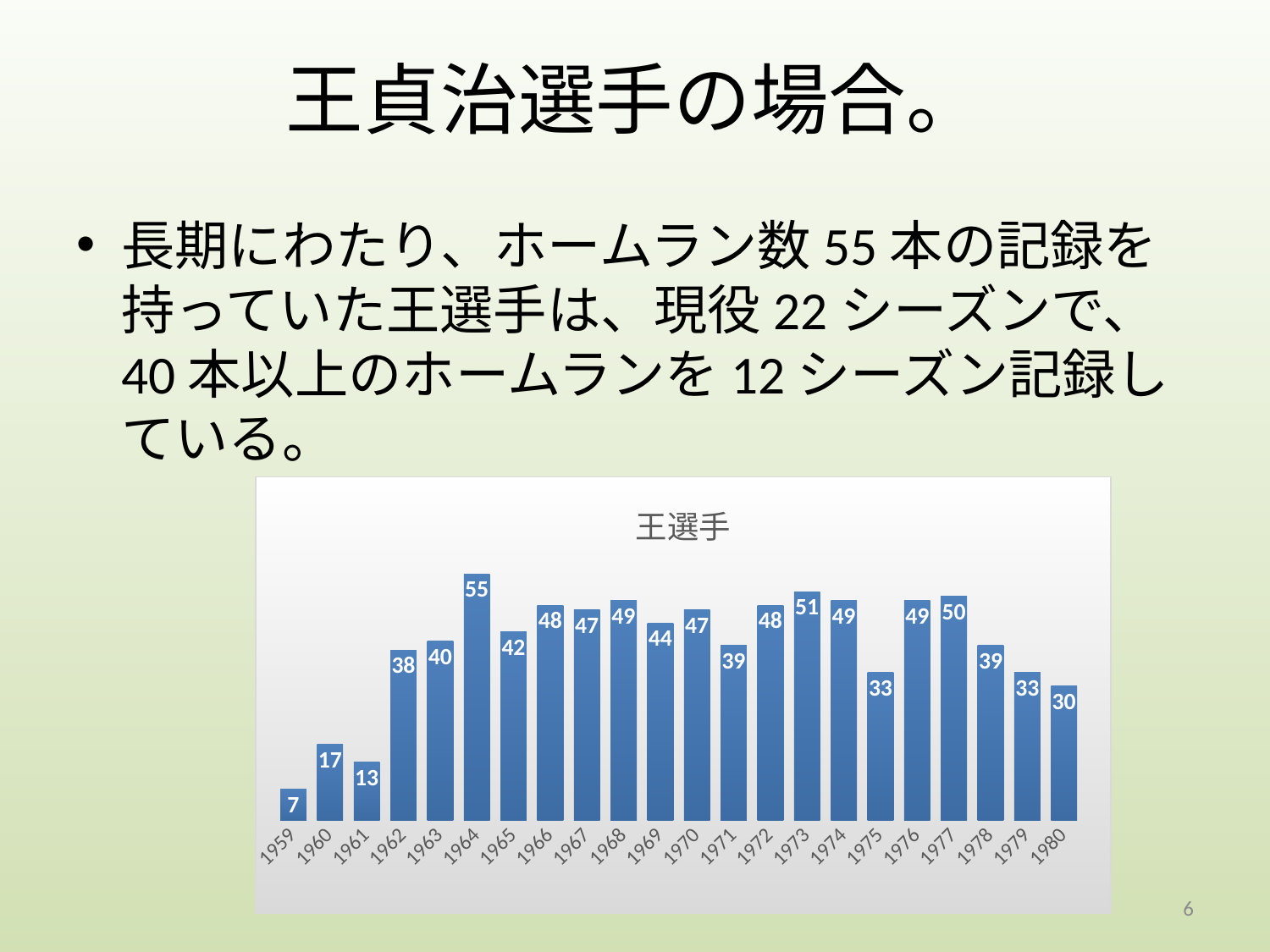
What kind of chart is shown on the slide? bar chart Which year has the lowest value? 1959 What is the title of the chart? 王選手 How many years are shown on the x axis? 22 What is the difference between the values for 1964 and 1980? 25 What is the value for 1964? 55 What is the value for 1959? 7 Which is larger, the value for 1962 or the value for 1965? 1965 Which year has the highest value? 1964 What is the difference between the values for 1973 and 1975? 18 Which is larger, the value for 1960 or the value for 1961? 1960 What is the value for 1977? 50